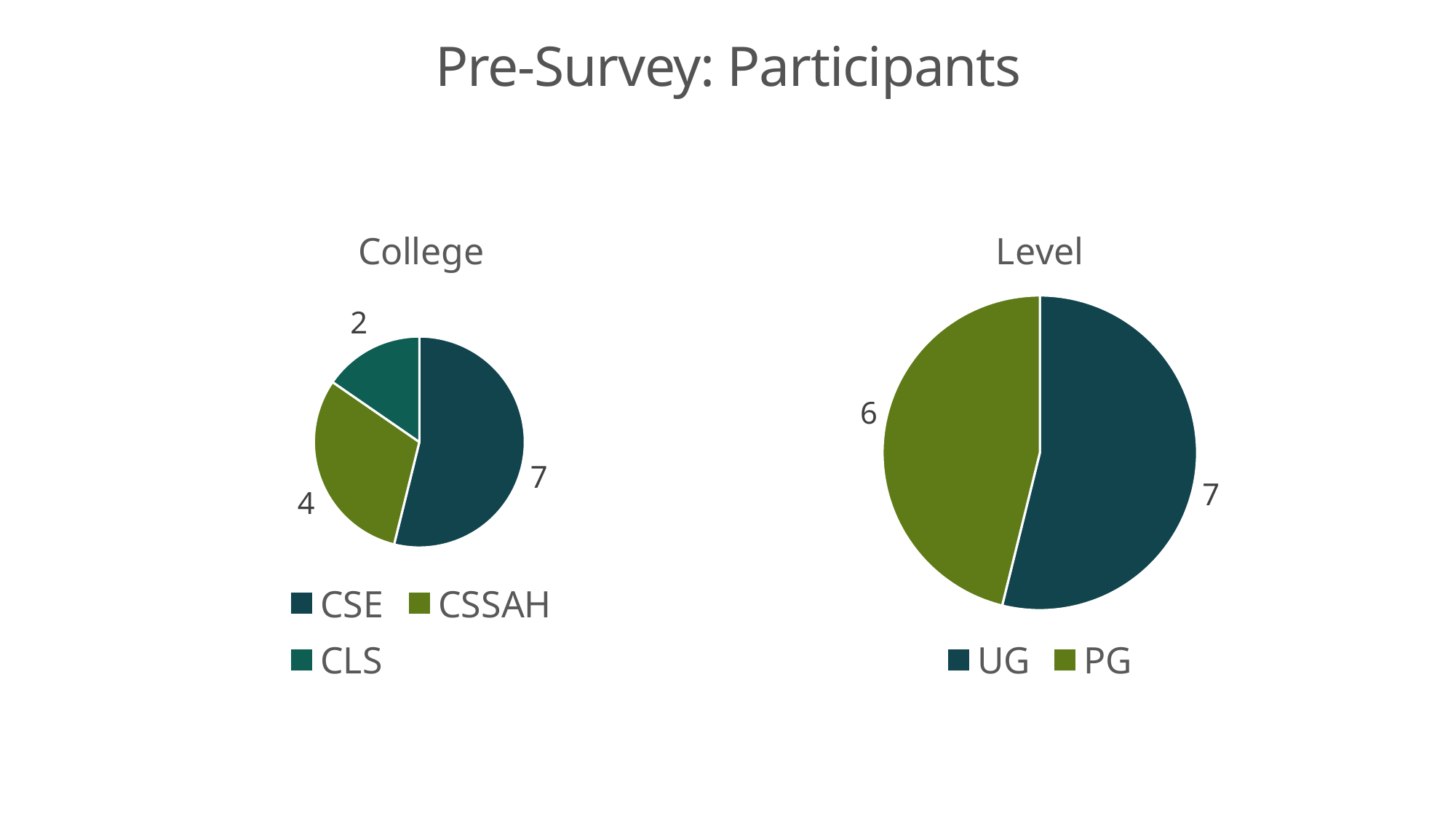
In the College chart, what share of the total does CSSAH represent? 4 of 13 In the College chart, which college has the smallest slice? CLS In the College chart, which college has the largest slice? CSE In the Level chart, what is the value for PG? 6 In the College chart, what is the value for CSE? 7 In the College chart, what is the difference between the CSE and CSSAH values? 3 In the College chart, what is the value for CLS? 2 How many entries does the legend of the Level chart list? 2 How many slices does the College chart have? 3 In the Level chart, which is larger, UG or PG? UG What is the title of the slide? Pre-Survey: Participants What kind of chart is the Level chart? Pie chart